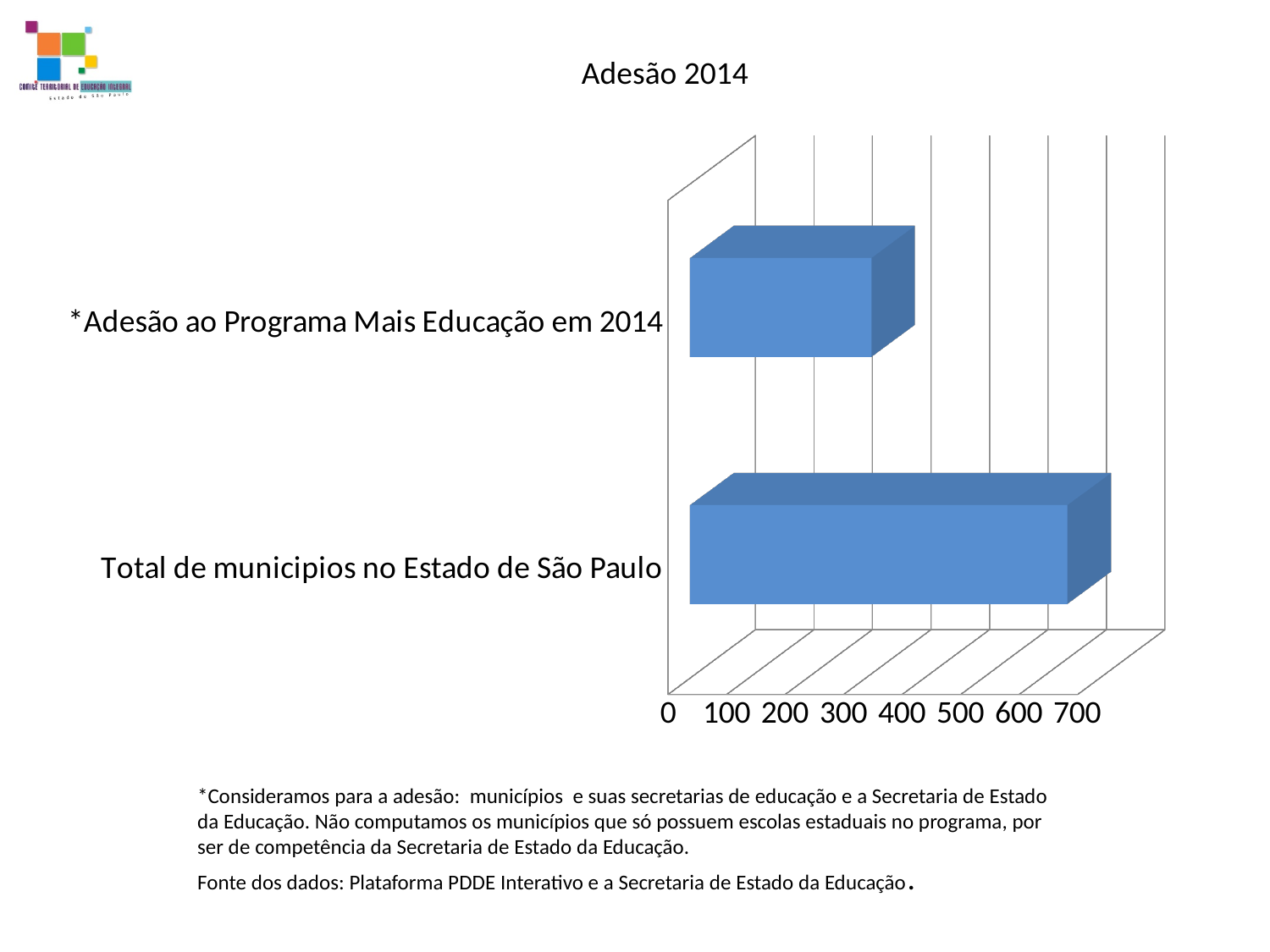
Which is larger: the value for 'Total de municipios no Estado de São Paulo' or the value for '*Adesão ao Programa Mais Educação em 2014'? Total de municipios no Estado de São Paulo Is the value for 'Total de municipios no Estado de São Paulo' greater or less than 700? less Is the value for 'Total de municipios no Estado de São Paulo' greater or less than 600? greater Which category has the longest bar? Total de municipios no Estado de São Paulo Is the value for '*Adesão ao Programa Mais Educação em 2014' greater or less than 400? less Which category has the shortest bar? *Adesão ao Programa Mais Educação em 2014 How many categories are plotted in the chart? 2 What is the highest value shown on the horizontal axis of the chart? 700 What is the title of the chart? Adesão 2014 What kind of chart is shown on the slide? bar chart